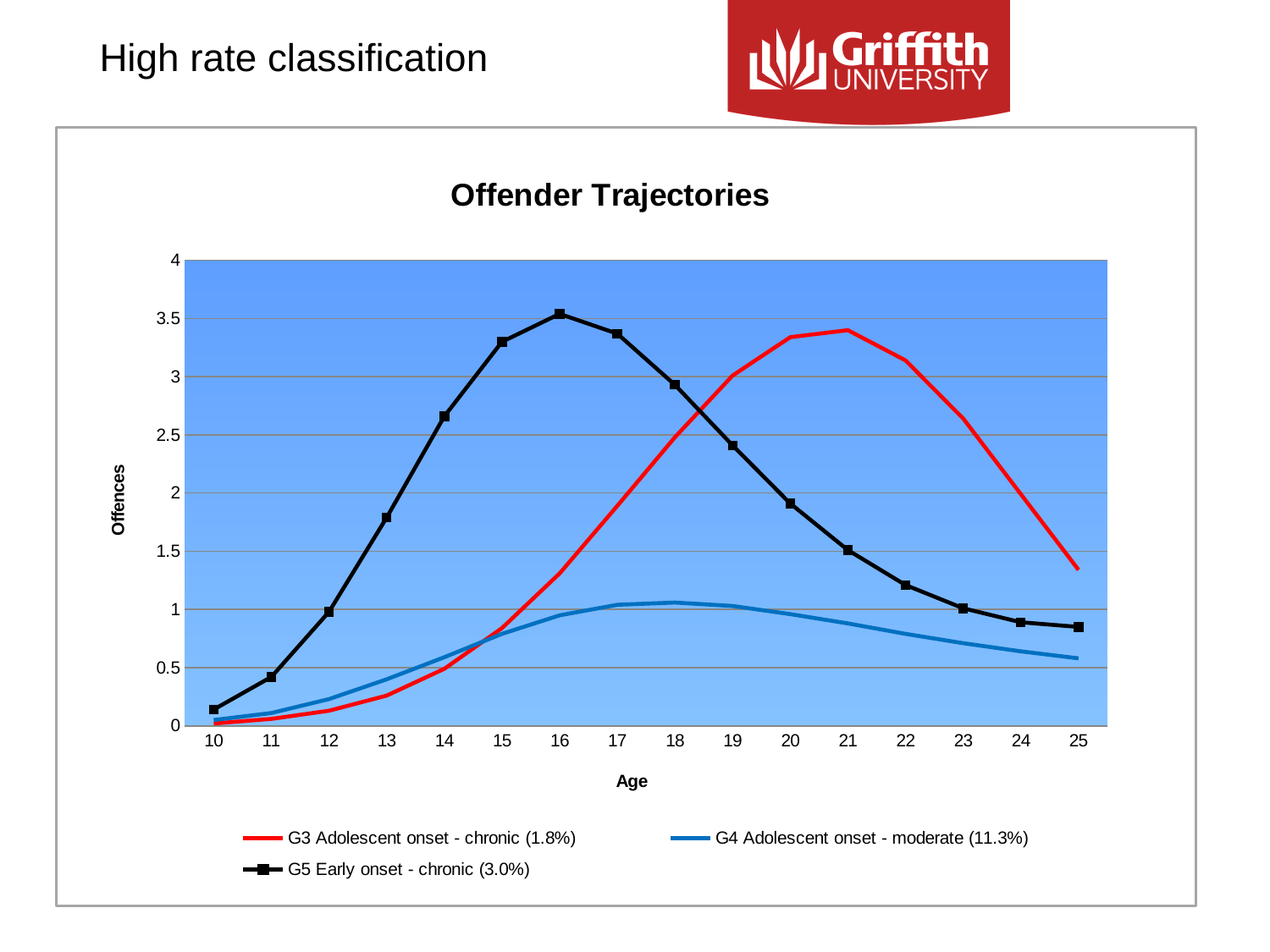
Is the value for G4 Adolescent onset - moderate at age 18 greater or less than 1.5? less How many series does the legend list? 3 At age 14, which series has the larger value: G5 Early onset - chronic or G3 Adolescent onset - chronic? G5 Early onset - chronic Does the G5 Early onset - chronic line rise or fall from age 16 to age 25? fall At age 21, which series has the larger value: G3 Adolescent onset - chronic or G5 Early onset - chronic? G3 Adolescent onset - chronic Is the value for G5 Early onset - chronic at age 10 greater or less than 0.5? less Is the value for G5 Early onset - chronic at age 16 greater or less than 3? greater Which series reaches the highest peak value on the chart? G5 Early onset - chronic (3.0%) What is the title of the chart? Offender Trajectories How many ages are shown along the x axis? 16 What kind of chart is shown on the slide? line chart